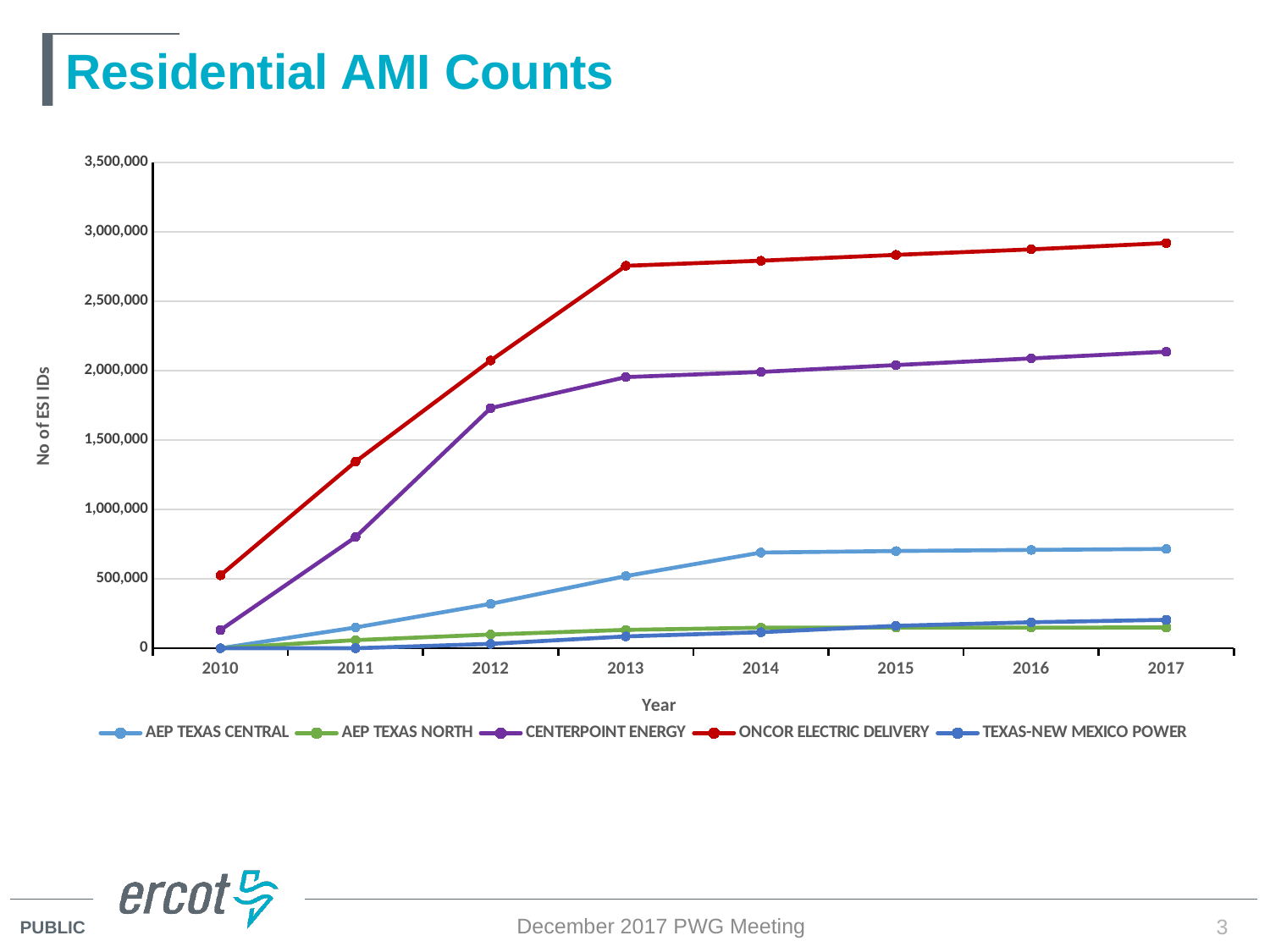
Which series has the highest value in 2017? ONCOR ELECTRIC DELIVERY Is the value for CENTERPOINT ENERGY in 2011 greater or less than 1,000,000? less What kind of chart is shown on the slide? line chart Do the values for ONCOR ELECTRIC DELIVERY rise or fall from 2010 to 2017? rise Is the value for ONCOR ELECTRIC DELIVERY in 2013 greater or less than 2,500,000? greater Is the value for AEP TEXAS CENTRAL in 2017 greater or less than 1,000,000? less How many series does the legend list? 5 In 2016, which is larger: AEP TEXAS CENTRAL or AEP TEXAS NORTH? AEP TEXAS CENTRAL In 2014, which is larger: ONCOR ELECTRIC DELIVERY or CENTERPOINT ENERGY? ONCOR ELECTRIC DELIVERY What is the label on the vertical axis? No of ESI IDs How many years are plotted along the x axis? 8